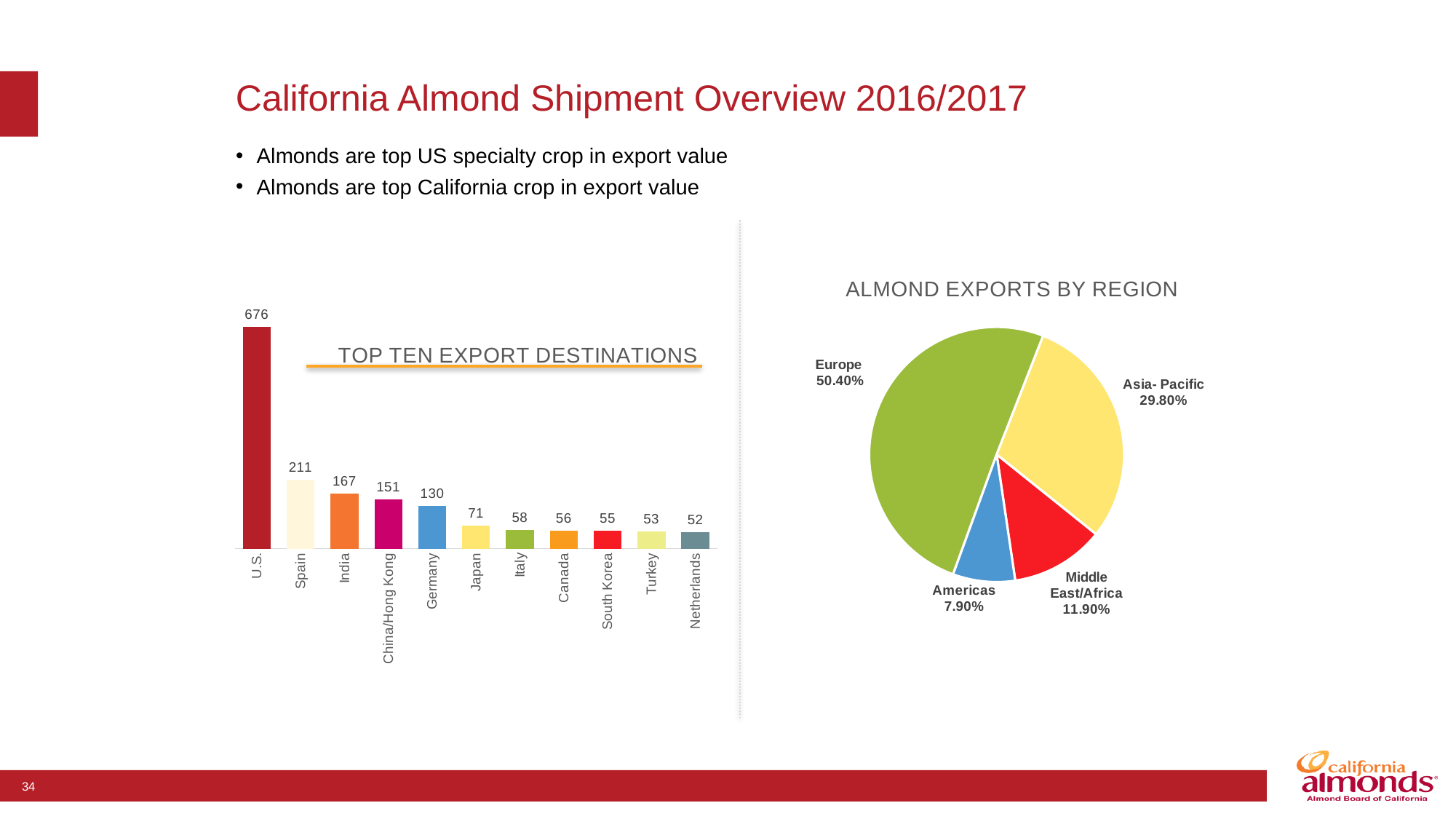
In the Top Ten Export Destinations chart, what is the value for Germany? 130 What kind of chart is the Almond Exports by Region chart? Pie chart In the Top Ten Export Destinations chart, which destination has the lowest value? Netherlands In the Almond Exports by Region chart, what share does Europe have? 50.40% In the Top Ten Export Destinations chart, what is the difference between the values for U.S. and Spain? 465 In the Almond Exports by Region chart, what is the difference between the shares of Asia-Pacific and Middle East/Africa? 17.90% In the Almond Exports by Region chart, which region has the smallest share? Americas What kind of chart is the Top Ten Export Destinations chart? Bar chart In the Top Ten Export Destinations chart, which destination has the highest value? U.S. In the Top Ten Export Destinations chart, which has a larger value, India or China/Hong Kong? India How many destinations are shown in the Top Ten Export Destinations chart? 11 In the Top Ten Export Destinations chart, what is the value for Spain? 211